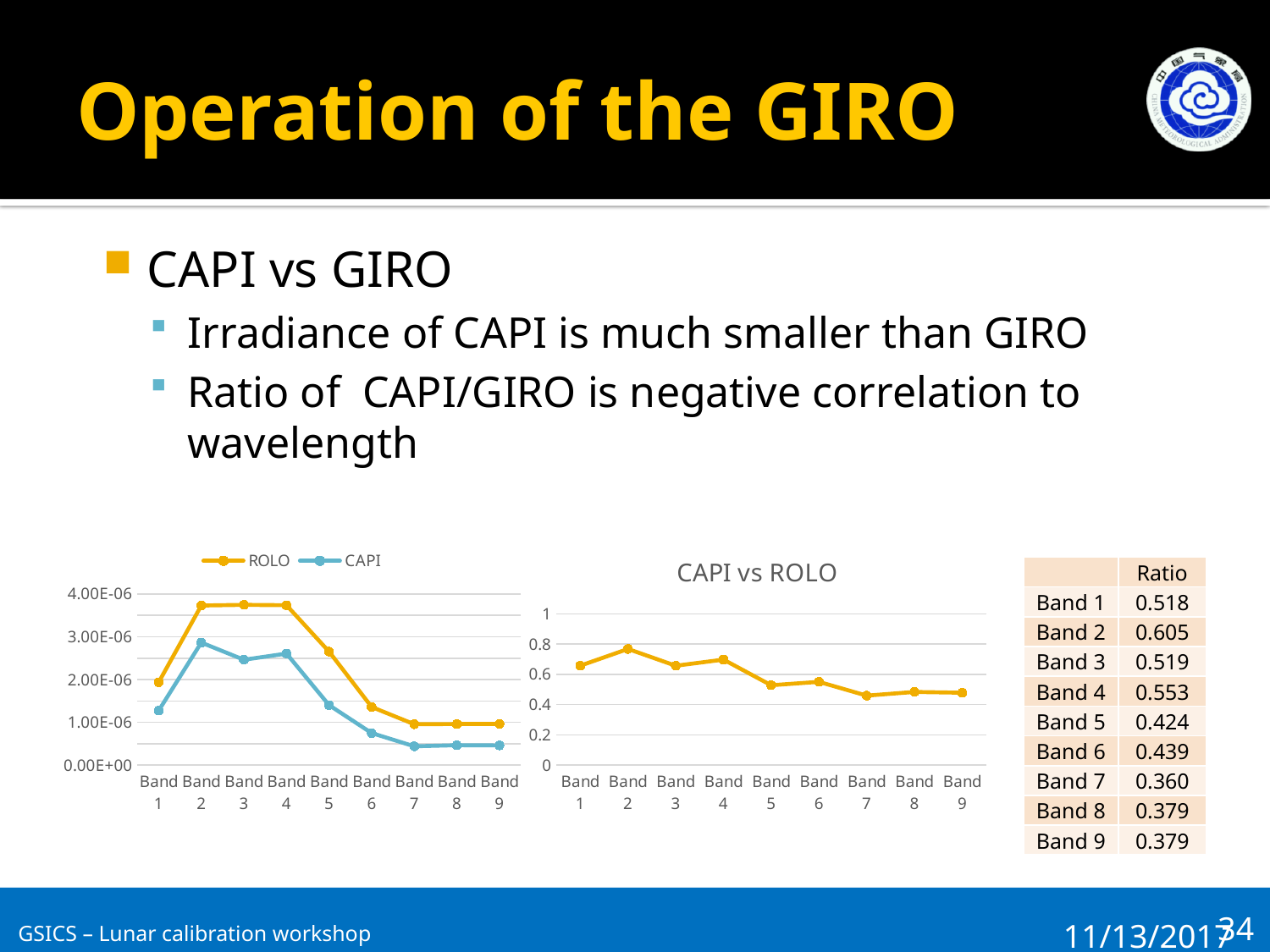
What kind of chart is the chart titled CAPI vs ROLO? line chart In the CAPI vs ROLO chart, do the values generally rise or fall from Band 1 to Band 9? fall How many bands are plotted along the x axis of the CAPI vs ROLO chart? 9 How many series does the legend of the left chart list? 2 In the left chart, is the ROLO value for Band 2 greater or less than 3.00E-06? greater In the CAPI vs ROLO chart, which is larger, the value for Band 2 or the value for Band 5? Band 2 In the CAPI vs ROLO chart, is the value for Band 5 greater or less than 0.6? less In the left chart, which series is higher at Band 4, ROLO or CAPI? ROLO In the CAPI vs ROLO chart, which band has the highest value? Band 2 In the CAPI vs ROLO chart, which band has the lowest value? Band 7 In the CAPI vs ROLO chart, is the value for Band 7 greater or less than 0.4? greater Which series are listed in the legend of the left chart? ROLO and CAPI